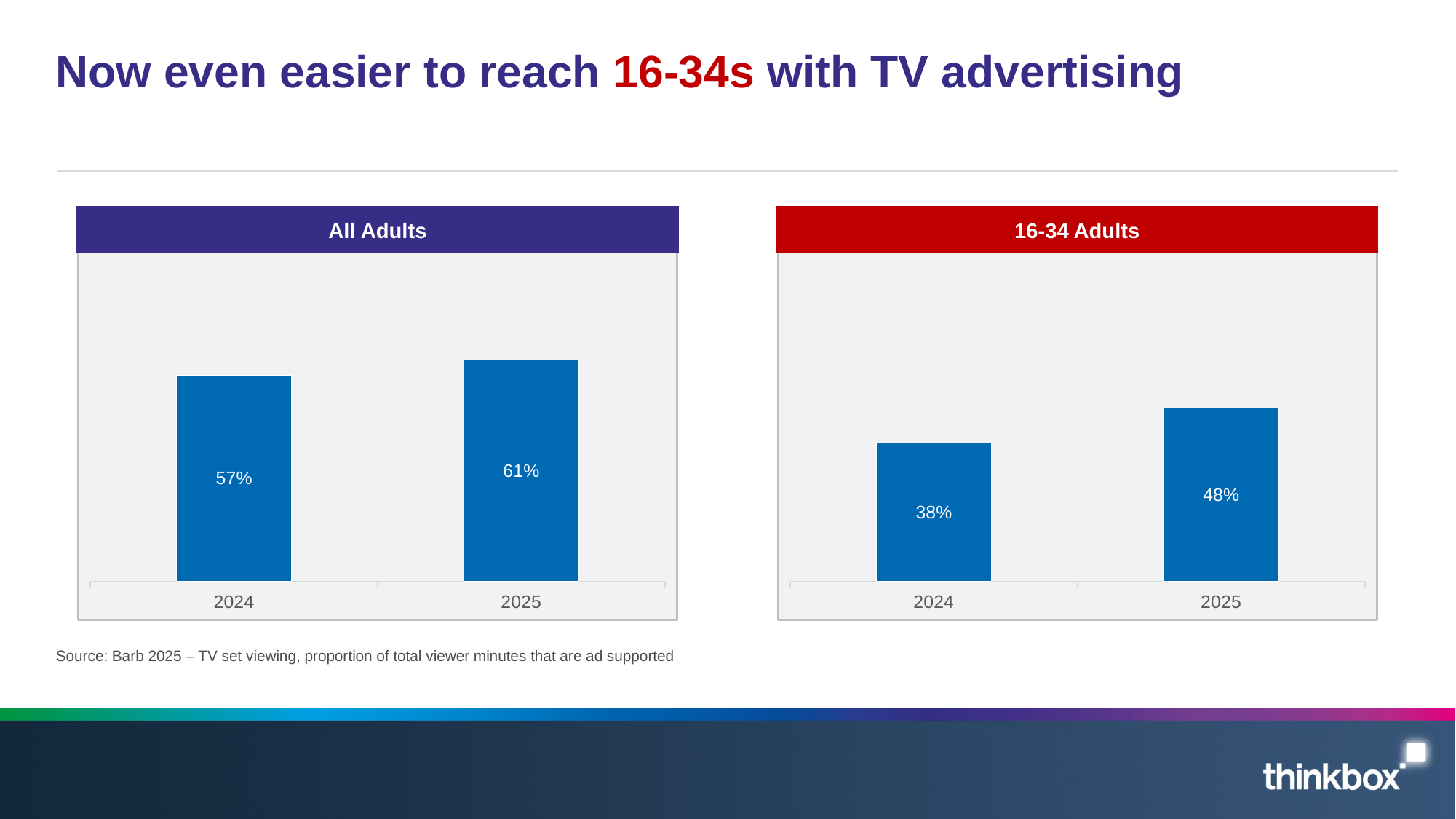
Which is larger: the 2025 value in the All Adults chart or the 2025 value in the 16-34 Adults chart? All Adults (61%) In the 16-34 Adults chart, what is the value for 2025? 48% In the All Adults chart, what is the value for 2024? 57% In the All Adults chart, what is the value for 2025? 61% In the 16-34 Adults chart, which year has the highest value? 2025 In the 16-34 Adults chart, what is the difference between the 2025 and 2024 values? 10 percentage points In the All Adults chart, which year has the lowest value? 2024 In the 16-34 Adults chart, do the values rise or fall from 2024 to 2025? Rise In the All Adults chart, how many bars are plotted? 2 What type of chart is the 16-34 Adults chart? Bar chart In the All Adults chart, what is the difference between the 2025 and 2024 values? 4 percentage points In the 16-34 Adults chart, what is the value for 2024? 38%